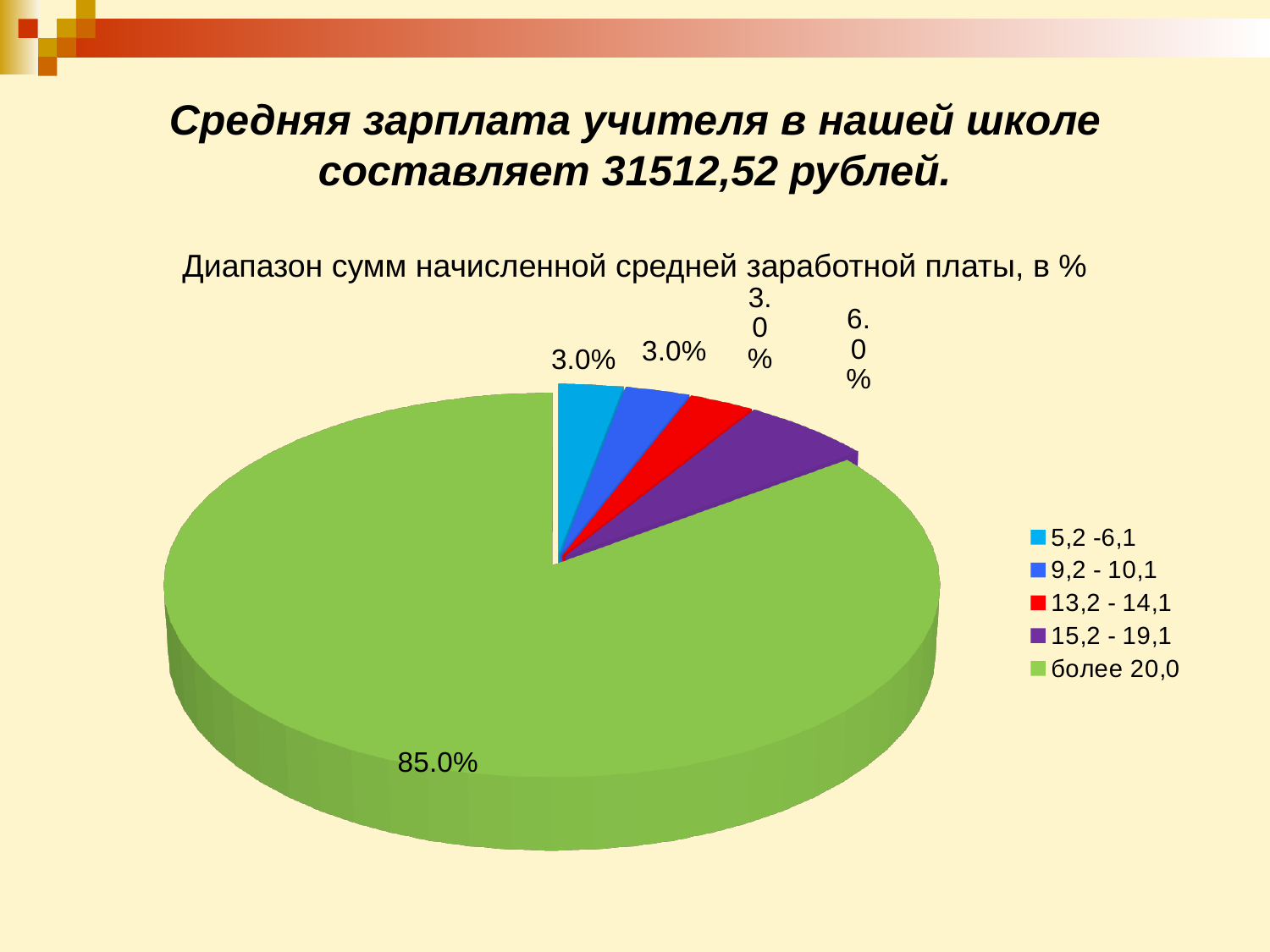
What is the difference between the value for '15,2 - 19,1' and the value for '5,2 -6,1'? 3.0% What is the value for the category '13,2 - 14,1'? 3.0% Which category has the largest slice of the pie? более 20,0 What is the value for the category 'более 20,0'? 85.0% What is the value for the category '5,2 -6,1'? 3.0% What is the value for the category '15,2 - 19,1'? 6.0% What is the difference between the value for 'более 20,0' and the value for '15,2 - 19,1'? 79.0% How many categories does the legend of the pie chart list? 5 Which colour represents the category 'более 20,0' in the legend? green What kind of chart is shown on the slide? pie chart What is the title of the chart? Диапазон сумм начисленной средней заработной платы, в % Which is larger, the slice for '15,2 - 19,1' or the slice for '9,2 - 10,1'? 15,2 - 19,1